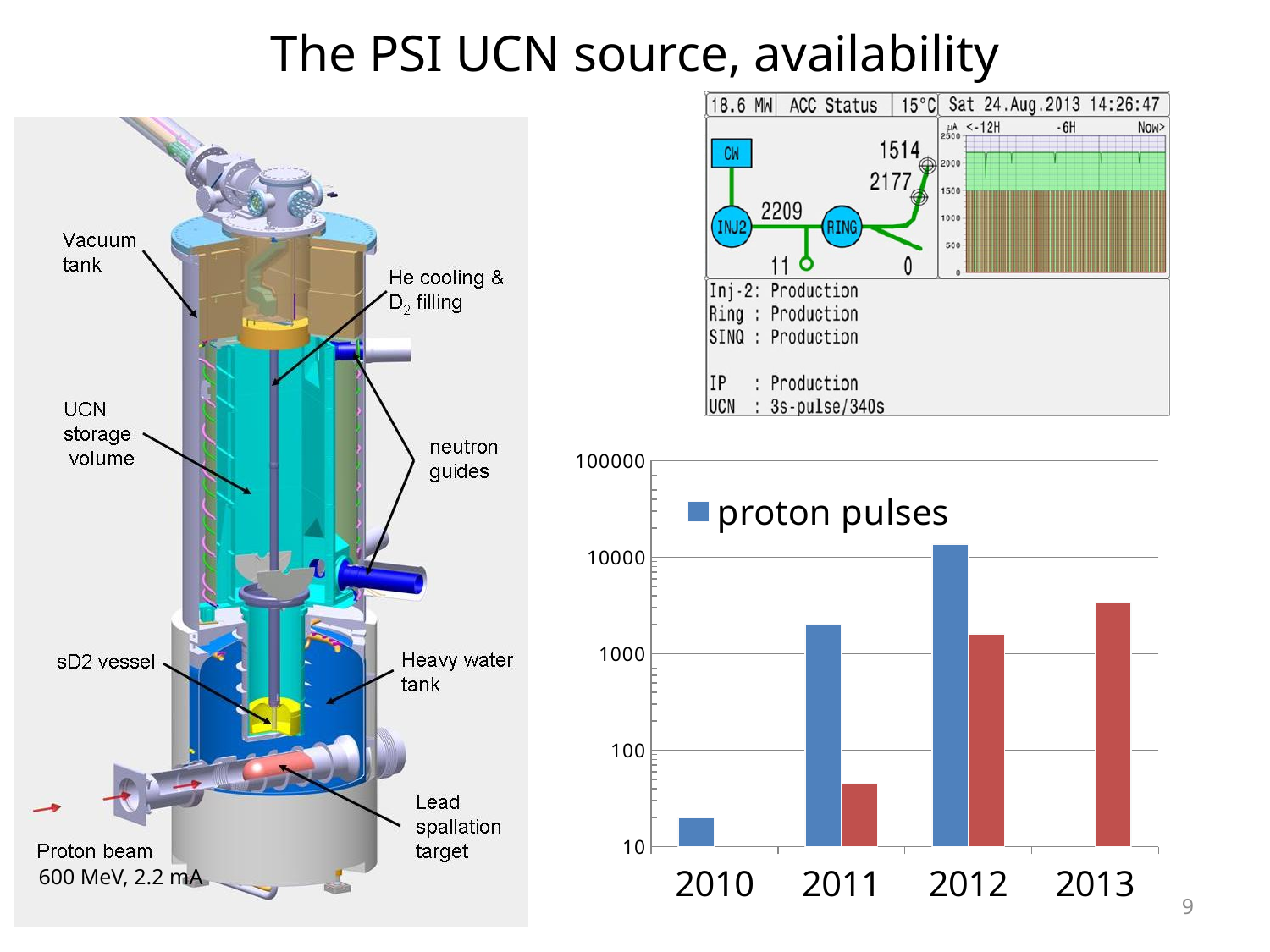
Is the proton pulses value for 2012 greater or less than 10000? greater How many series does the legend of the bar chart list? 1 What is the series name shown in the legend of the bar chart? proton pulses In which year is the proton pulses value highest in the bar chart? 2012 In which year is the proton pulses value lowest in the bar chart? 2010 How many years are shown on the x axis of the bar chart? 4 Do the proton pulses values rise or fall from 2010 to 2012? rise Is the proton pulses value for 2011 greater or less than 1000? greater Which year in the bar chart has no proton pulses bar? 2013 Which year has the larger proton pulses value, 2011 or 2012? 2012 Is the proton pulses value for 2010 greater or less than 100? less What kind of chart is shown at the bottom right of the slide? bar chart